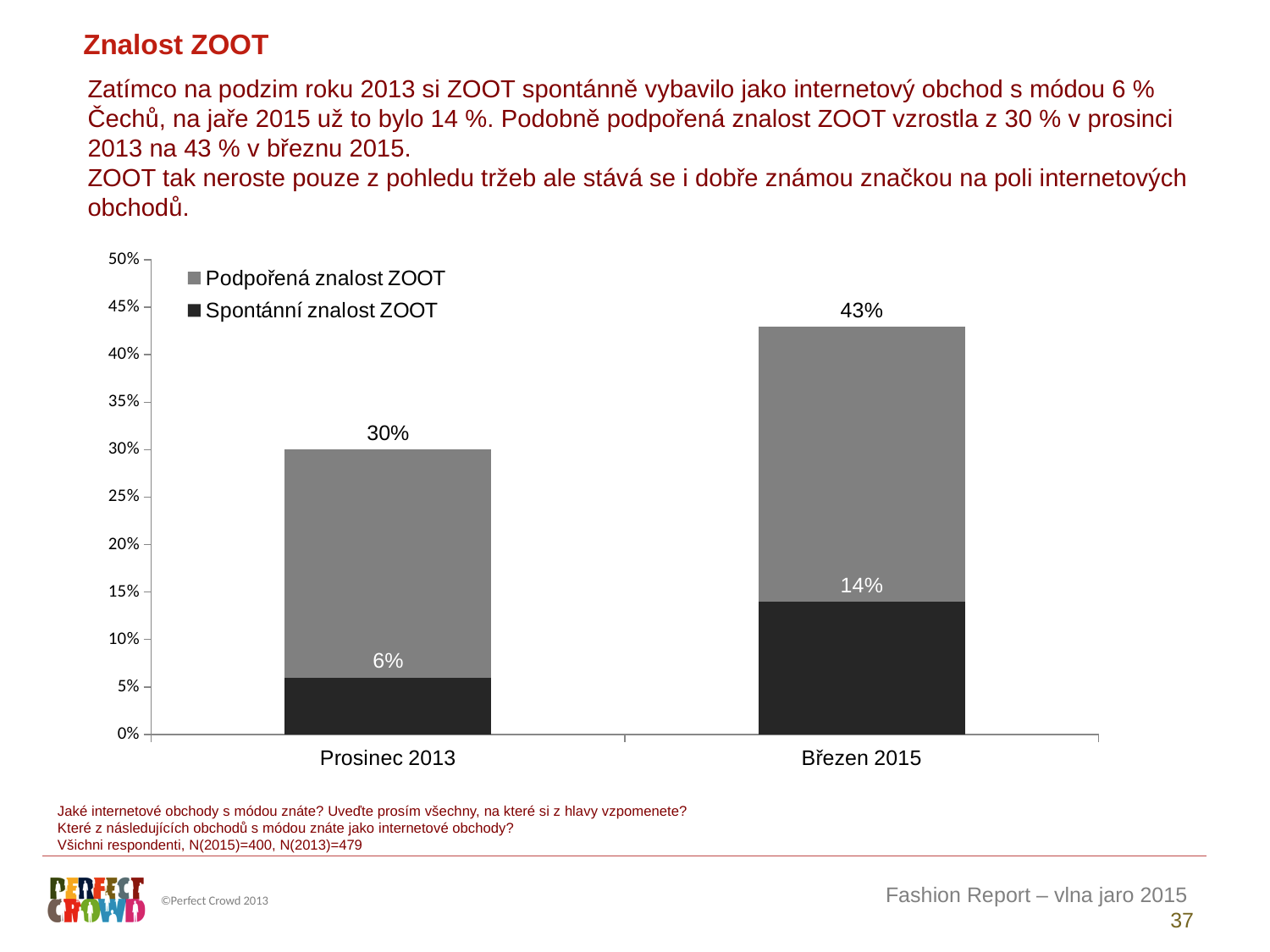
Do the values for Podpořená znalost ZOOT rise or fall from Prosinec 2013 to Březen 2015? Rise By how many percentage points did Podpořená znalost ZOOT increase from Prosinec 2013 to Březen 2015? 13 percentage points What is the value for Spontánní znalost ZOOT in Březen 2015? 14% What is the value for Podpořená znalost ZOOT in Březen 2015? 43% How many time periods are shown on the x axis? 2 What is the value for Podpořená znalost ZOOT in Prosinec 2013? 30% Which period has the higher value for Spontánní znalost ZOOT, Prosinec 2013 or Březen 2015? Březen 2015 Is the value for Podpořená znalost ZOOT in Březen 2015 greater or less than 40%? greater What kind of chart is shown on the slide? Bar chart How many series does the legend list? 2 What is the value for Spontánní znalost ZOOT in Prosinec 2013? 6% What is the difference between Spontánní znalost ZOOT in Březen 2015 and in Prosinec 2013? 8 percentage points